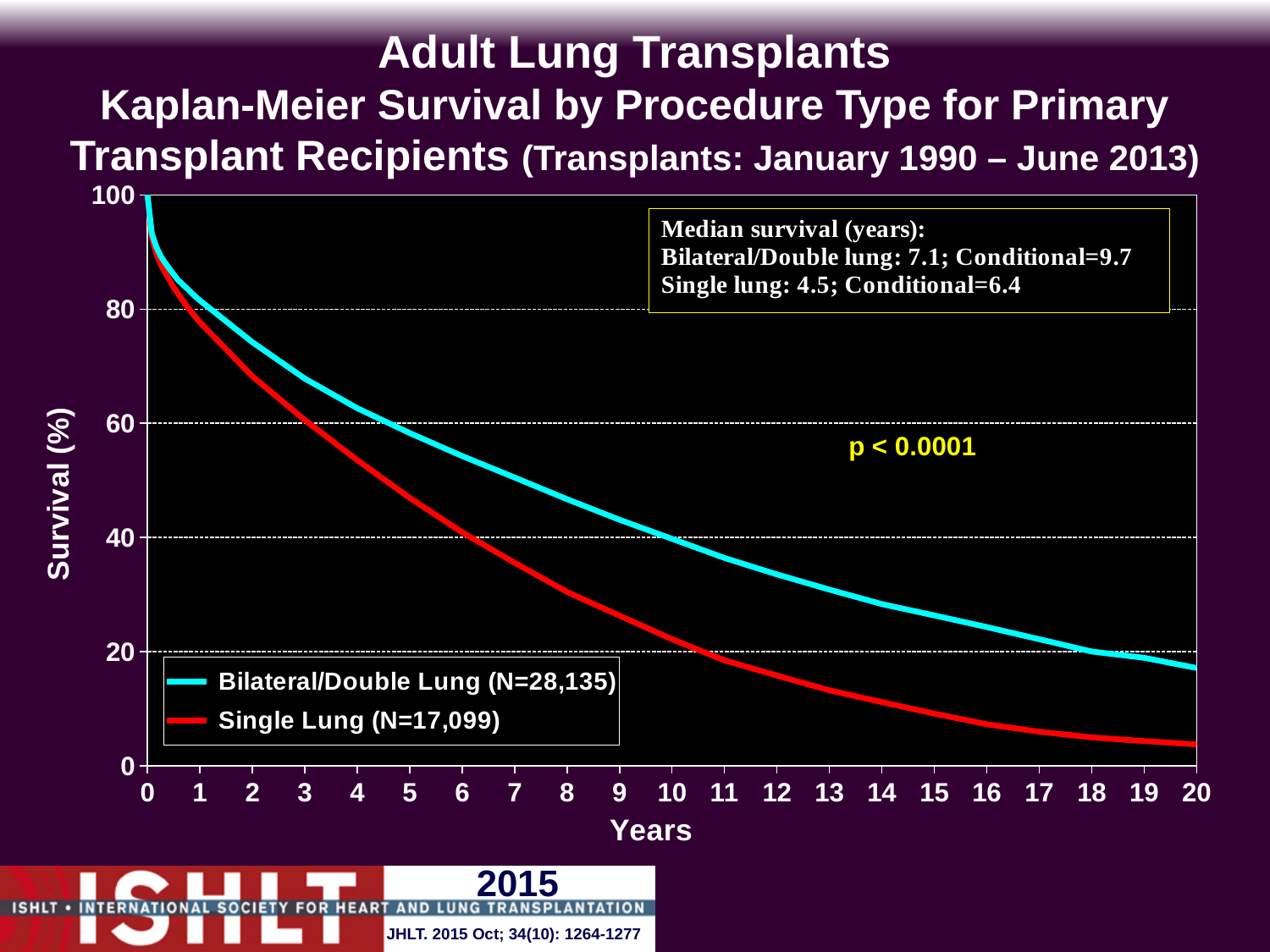
How many series does the legend list? 2 What is the median survival in years for Bilateral/Double lung recipients? 7.1 Is the survival for Bilateral/Double Lung at 5 years greater or less than 40? greater What is the median survival in years for Single lung recipients? 4.5 What p-value is shown on the chart? p < 0.0001 Which procedure type has the higher survival at 10 years, Bilateral/Double Lung or Single Lung? Bilateral/Double Lung What is the conditional median survival in years for Bilateral/Double lung recipients? 9.7 Is the survival for Single Lung at 15 years greater or less than 20? less Do the survival curves rise or fall as years increase? fall What is the conditional median survival in years for Single lung recipients? 6.4 What kind of chart is shown on the slide? line chart What is the N for the Single Lung group shown in the legend? 17,099